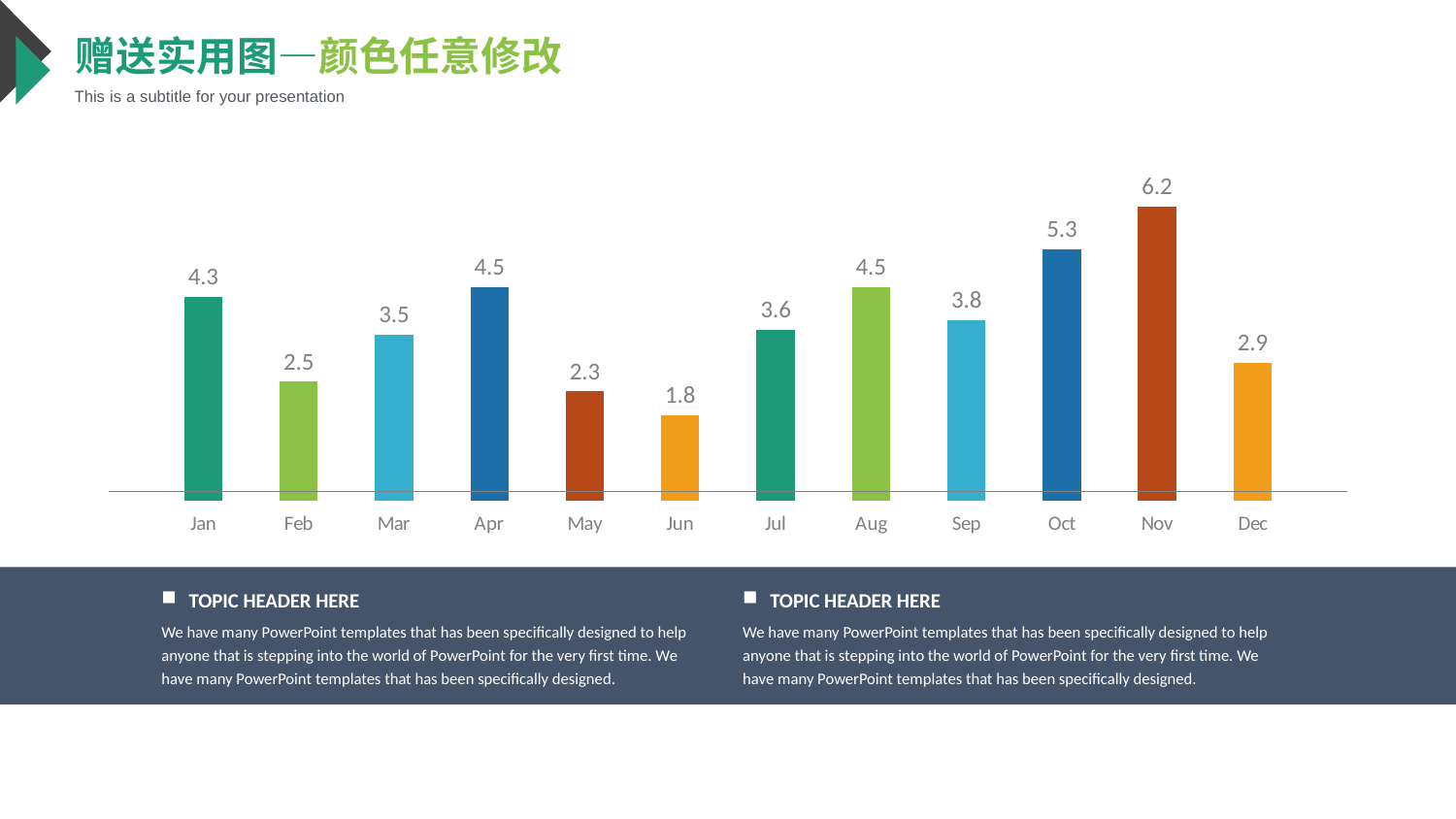
What is the difference between the values for Jan and Feb? 1.8 What is the value for Dec? 2.9 Which month has the highest value? Nov Which month has the lowest value? Jun What kind of chart is shown on the slide? Bar chart Do the values rise or fall from Sep to Nov? Rise What is the value for Nov? 6.2 What is the difference between the values for Nov and Oct? 0.9 How many months are shown on the x axis? 12 Which is larger, the value for Sep or the value for Jul? Sep What is the value for Jun? 1.8 What is the value for Jan? 4.3